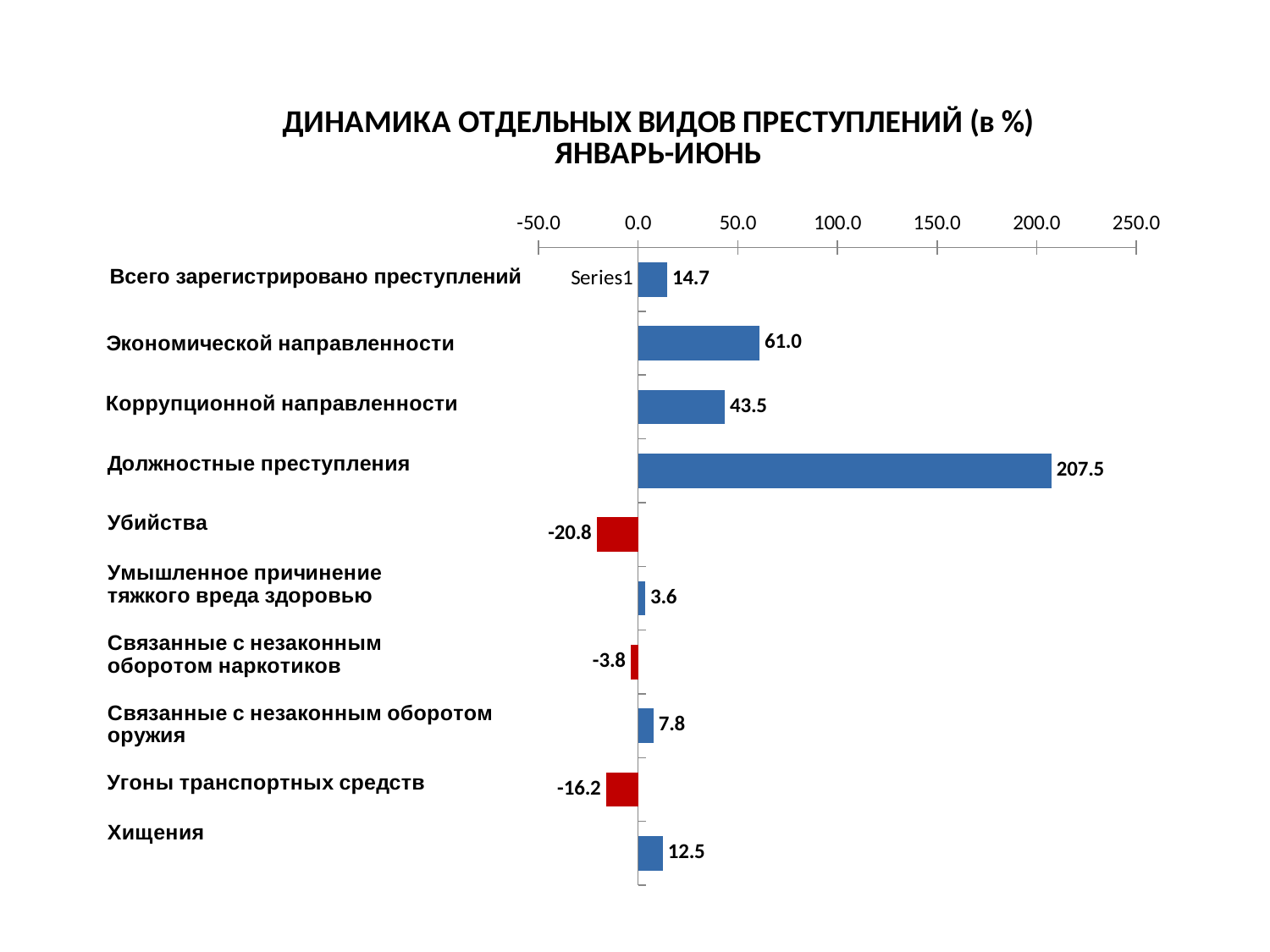
Is the value for Должностные преступления greater or less than 200.0? greater What is the difference between the values for Экономической направленности and Коррупционной направленности? 17.5 Which is larger, the value for Хищения or the value for Всего зарегистрировано преступлений? Всего зарегистрировано преступлений How many categories are shown in the chart? 10 Which category has the lowest value? Убийства What is the value for Убийства? -20.8 What is the value for Должностные преступления? 207.5 What is the value for Экономической направленности? 61.0 What kind of chart is shown on the slide? bar chart What is the value for Угоны транспортных средств? -16.2 How many bars in the chart have negative values? 3 Which category has the highest value? Должностные преступления